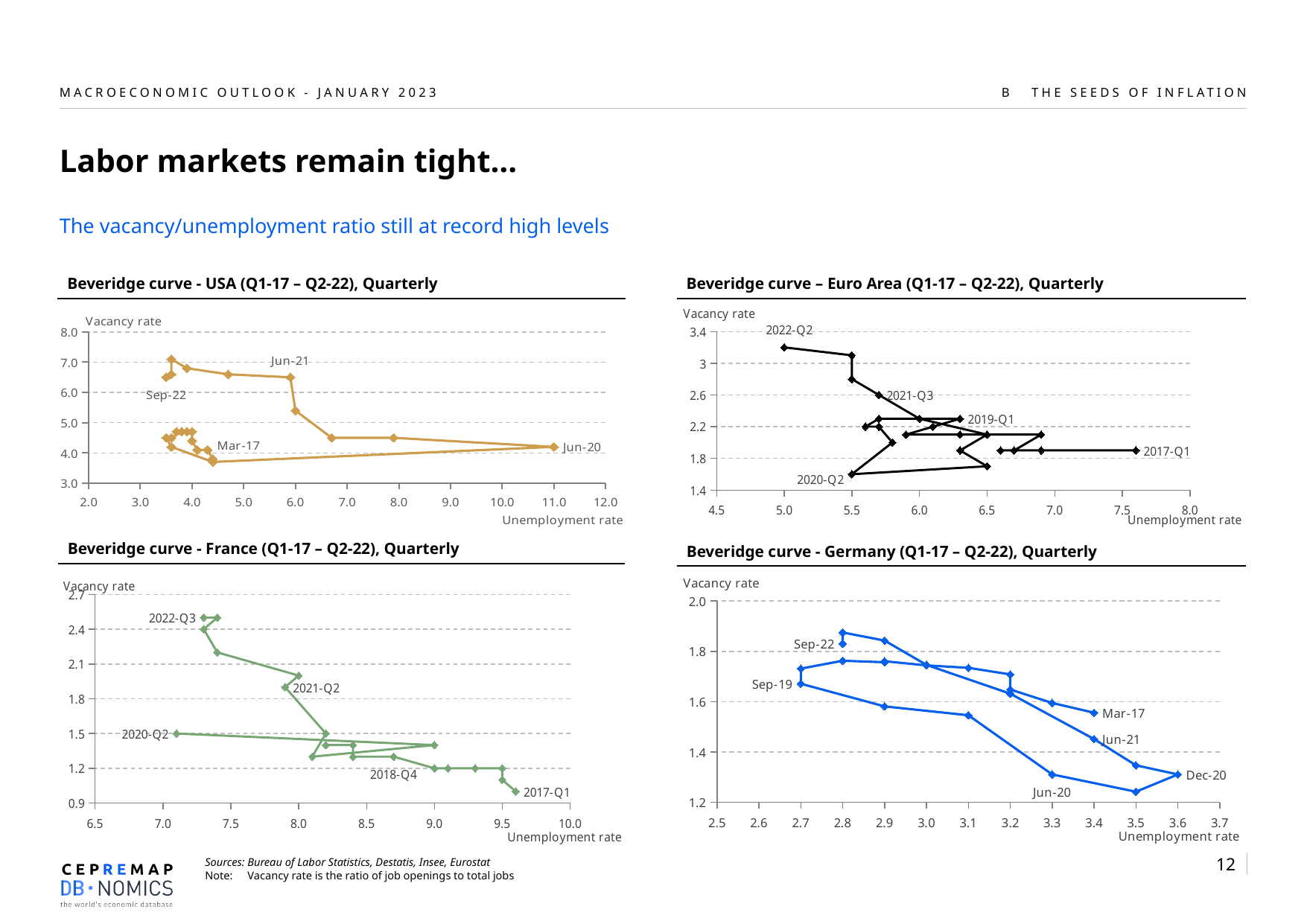
In the Beveridge curve – Euro Area chart, is the unemployment rate at 2017-Q1 greater or less than 7.0? greater In the Beveridge curve - Germany chart, which point has the higher vacancy rate, Sep-22 or Jun-20? Sep-22 In the Beveridge curve - USA chart, is the unemployment rate at Jun-20 greater or less than 10.0? greater In the Beveridge curve - Germany chart, is the unemployment rate at Dec-20 greater or less than 3.4? greater What is the label of the horizontal axis on the Beveridge curve - Germany chart? Unemployment rate What colour is the line in the Beveridge curve - France chart? Green What kind of chart is the Beveridge curve - USA chart? Line chart (scatter with connected points) In the Beveridge curve - USA chart, which point has the higher unemployment rate, Jun-21 or Jun-20? Jun-20